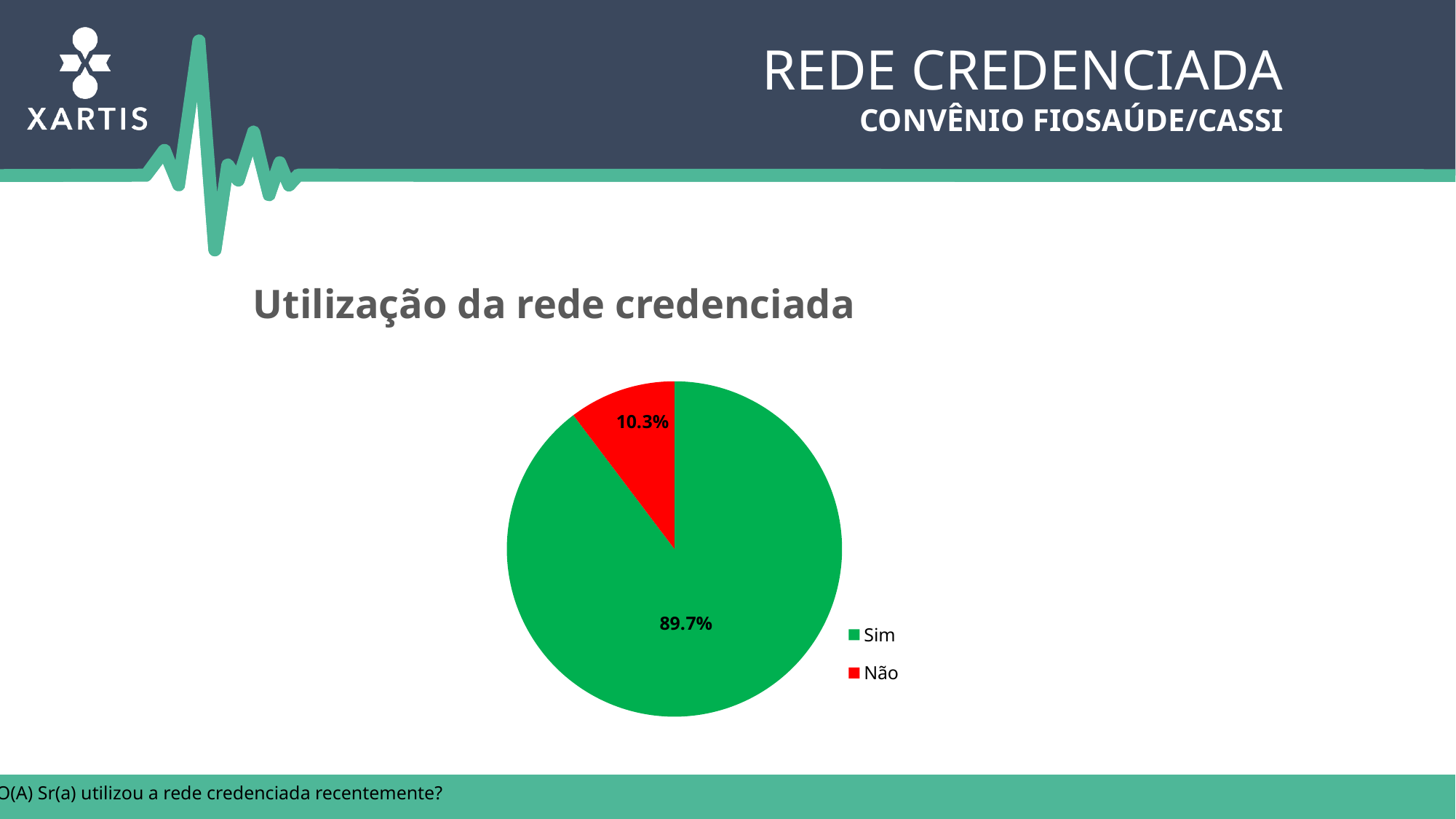
What is the difference in percentage points between the "Sim" and "Não" slices? 79.4 Which category has the smallest slice of the pie? Não What share of the pie does "Sim" represent? 89.7% How many entries does the legend list? 2 How many categories does the pie chart have? 2 What kind of chart is shown on the slide? pie chart What is the title of the chart? Utilização da rede credenciada What share of the pie does "Não" represent? 10.3% Which category has the largest slice of the pie? Sim Which is larger, the "Sim" slice or the "Não" slice? Sim What colour is the "Não" slice? red